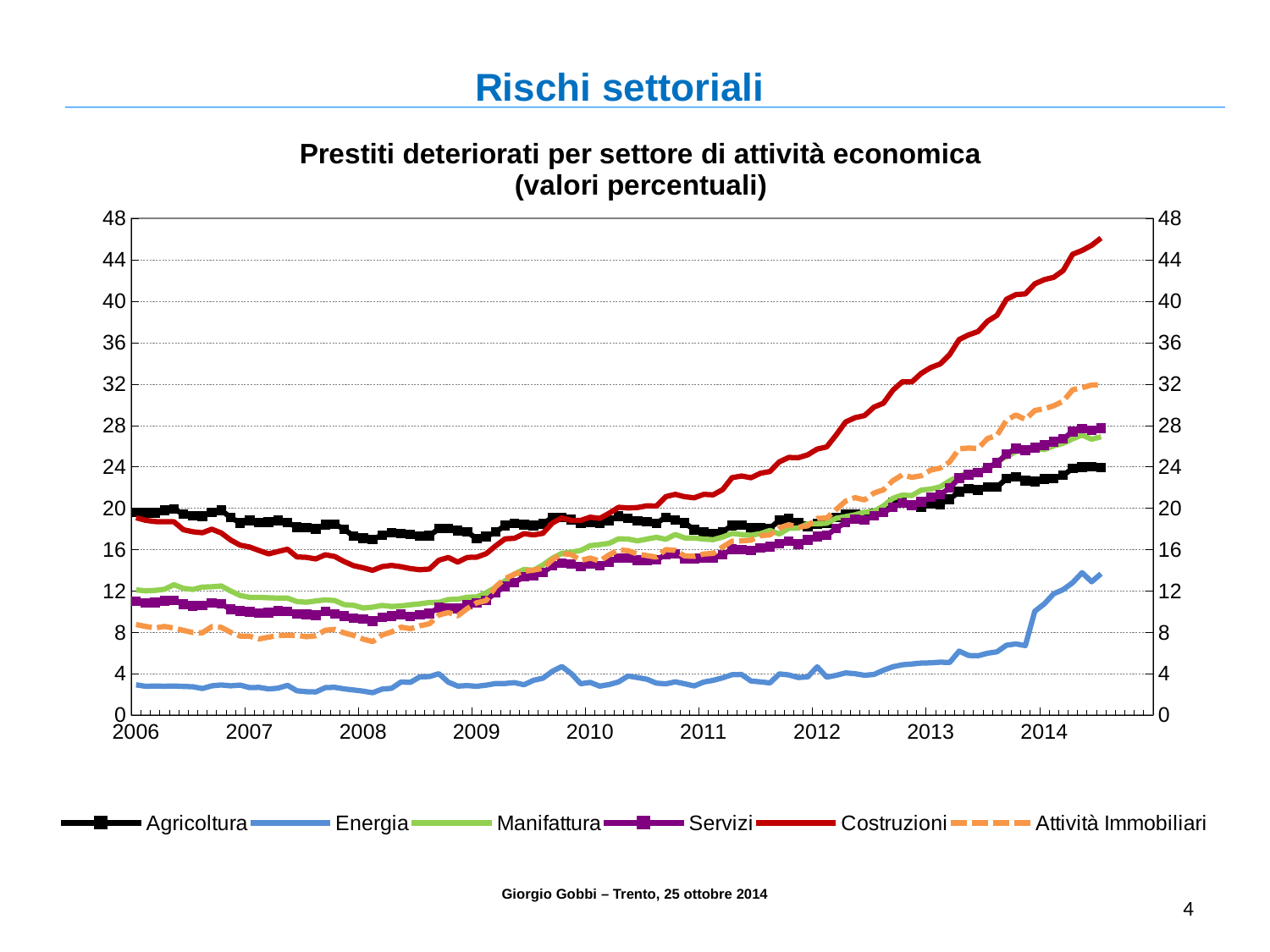
Which series has the highest value at the end of the period in 2014? Costruzioni Is the value for Costruzioni at the start of 2008 greater or less than 16? less What is the title of the chart? Prestiti deteriorati per settore di attività economica (valori percentuali) What kind of chart is shown on the slide? line chart Is the value for Energia at the start of 2006 greater or less than 4? less At the start of 2007, which is larger: Agricoltura or Costruzioni? Agricoltura Is the value for Costruzioni at the end of 2014 greater or less than 44? greater How many series does the legend list? 6 Does the Costruzioni series rise or fall between 2009 and 2014? rise Which series is drawn with a dashed line? Attività Immobiliari Which series has the lowest values throughout the whole period? Energia